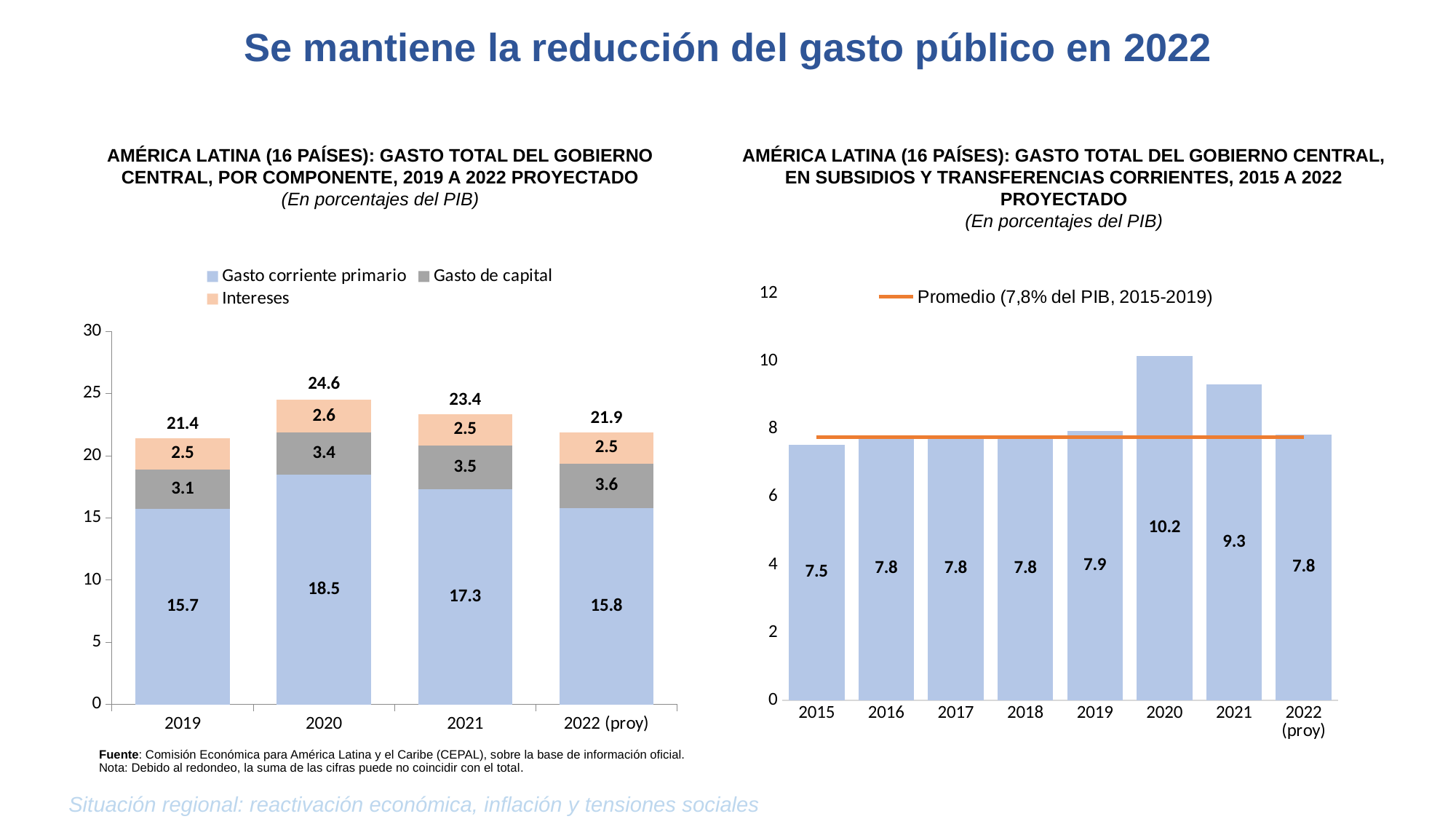
What type of chart is the right chart (Gasto en subsidios y transferencias corrientes)? Bar chart In the right chart (Gasto en subsidios y transferencias corrientes), what is the difference between the 2020 value and the 2022 (proy) value? 2.4 In the left chart (Gasto total del gobierno central, por componente), how many series does the legend list? 3 In the left chart (Gasto total del gobierno central, por componente), what is the total of the stacked bar for 2021? 23.4 In the right chart (Gasto en subsidios y transferencias corrientes), is the value for 2021 larger than the value for 2019? Yes In the right chart (Gasto en subsidios y transferencias corrientes), which year has the lowest value? 2015 In the left chart (Gasto total del gobierno central, por componente), which year has the highest total? 2020 In the left chart (Gasto total del gobierno central, por componente), what is the difference between Gasto corriente primario in 2020 and in 2021? 1.2 In the left chart (Gasto total del gobierno central, por componente), what is the value of Gasto de capital for 2022 (proy)? 3.6 In the right chart (Gasto en subsidios y transferencias corrientes), how many years are plotted? 8 In the right chart (Gasto en subsidios y transferencias corrientes), what is the value for 2020? 10.2 In the left chart (Gasto total del gobierno central, por componente), what is the value of Gasto corriente primario for 2020? 18.5